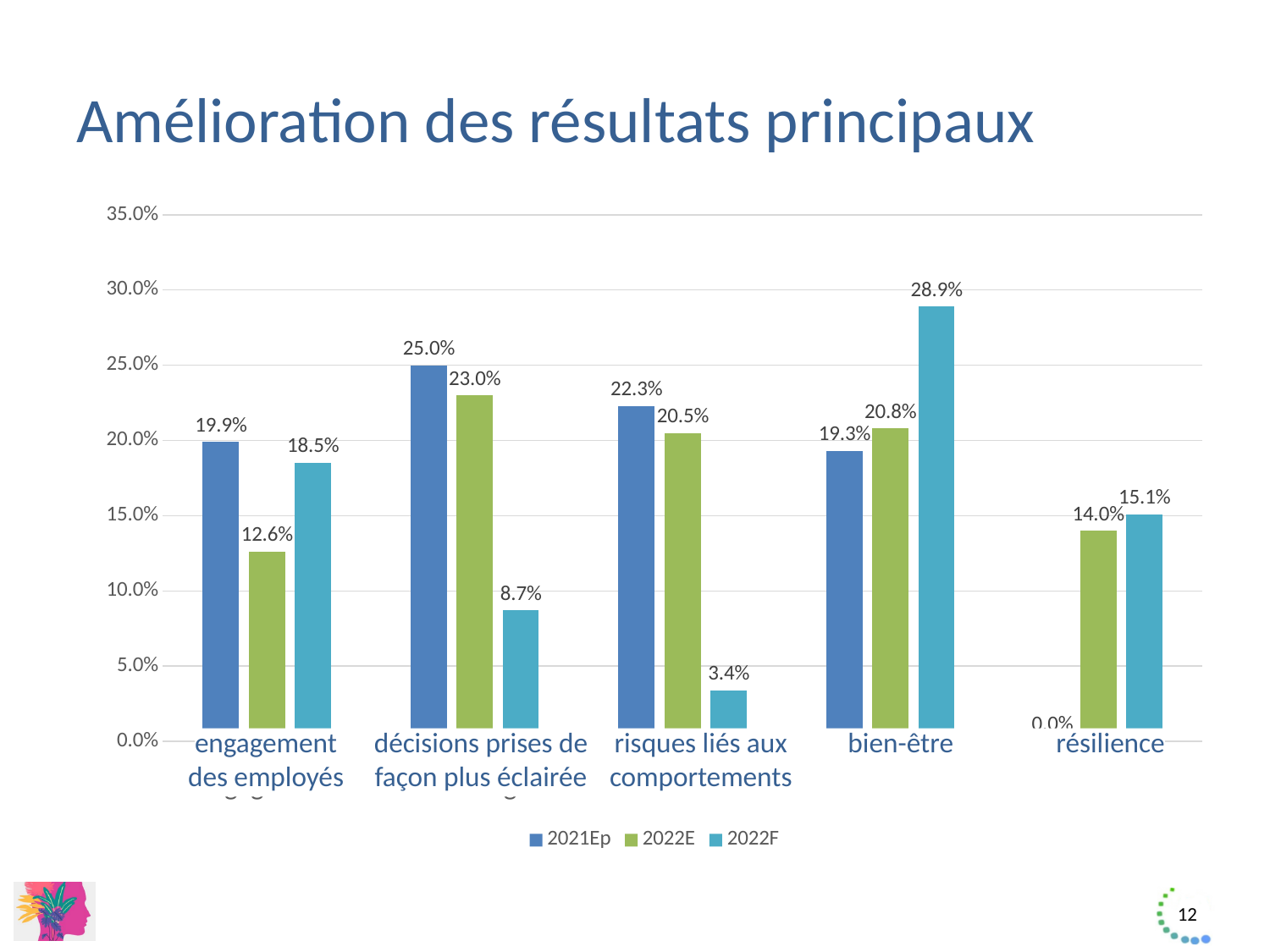
What is the 2022F value for bien-être? 28.9% How many categories are shown on the x axis? 5 What is the 2022E value for engagement des employés? 12.6% Which category has the highest 2022F value? bien-être What is the difference between the 2021Ep and 2022E values for engagement des employés? 7.3% Which is larger for résilience: the 2022E value or the 2022F value? 2022F What is the 2021Ep value for décisions prises de façon plus éclairée? 25.0% What is the 2022F value for risques liés aux comportements? 3.4% Which category has the lowest 2021Ep value? résilience What kind of chart is shown on the slide? bar chart What is the title of the slide? Amélioration des résultats principaux How many series does the legend list? 3